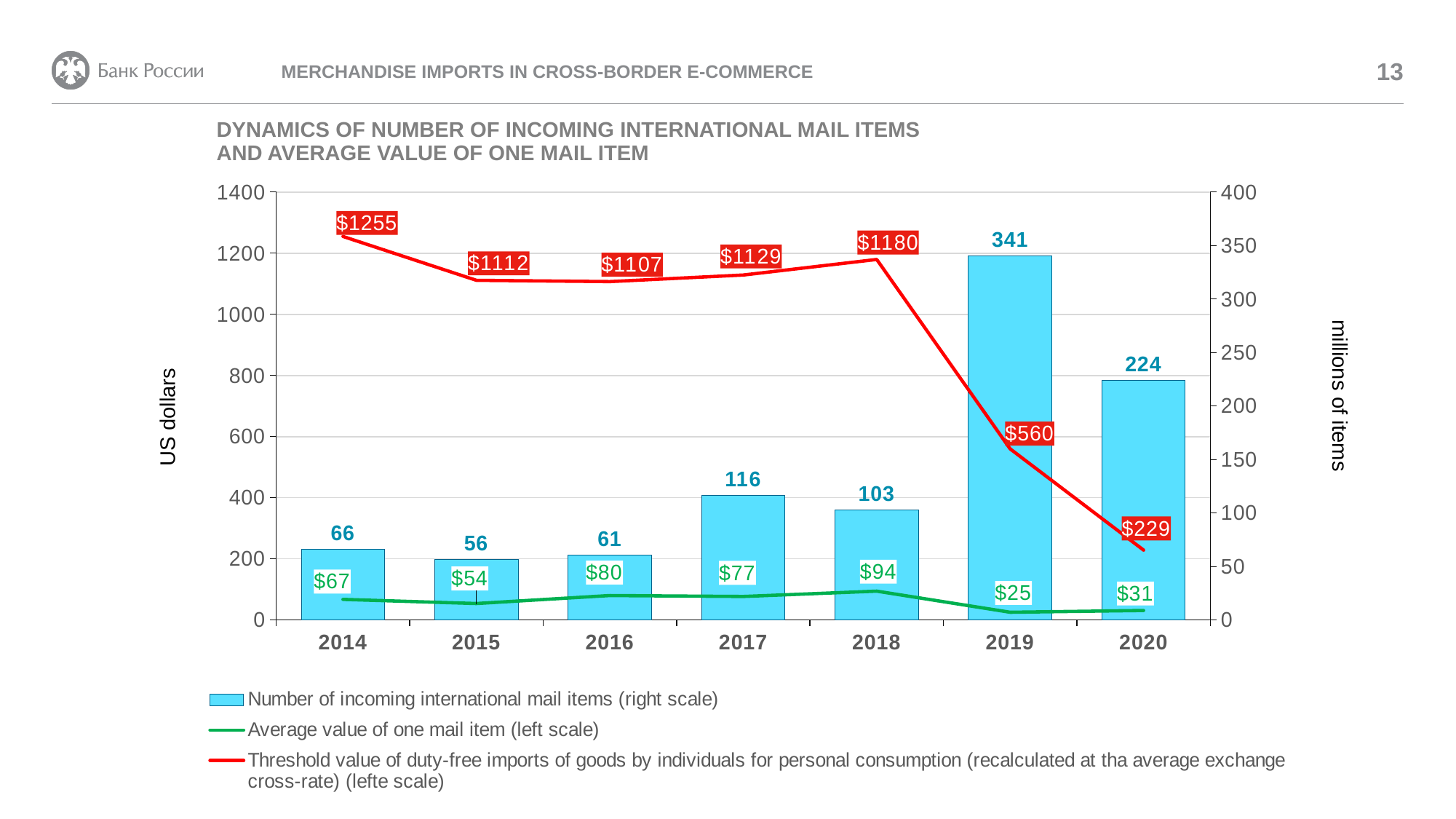
What is the threshold value of duty-free imports in 2014? $1255 In which year is the number of incoming international mail items highest? 2019 How many series does the legend list? 3 What is the average value of one mail item in 2018? $94 Which year has the larger threshold value of duty-free imports, 2014 or 2018? 2014 How many years are shown on the x axis? 7 In which year is the average value of one mail item lowest? 2019 What is the difference between the number of incoming international mail items in 2019 and in 2020? 117 Which scale is the number of incoming international mail items plotted on, according to the legend? Right scale What is the number of incoming international mail items in 2019? 341 What kind of chart is used to show the number of incoming international mail items? Bar chart Does the threshold value of duty-free imports rise or fall from 2018 to 2020? Fall